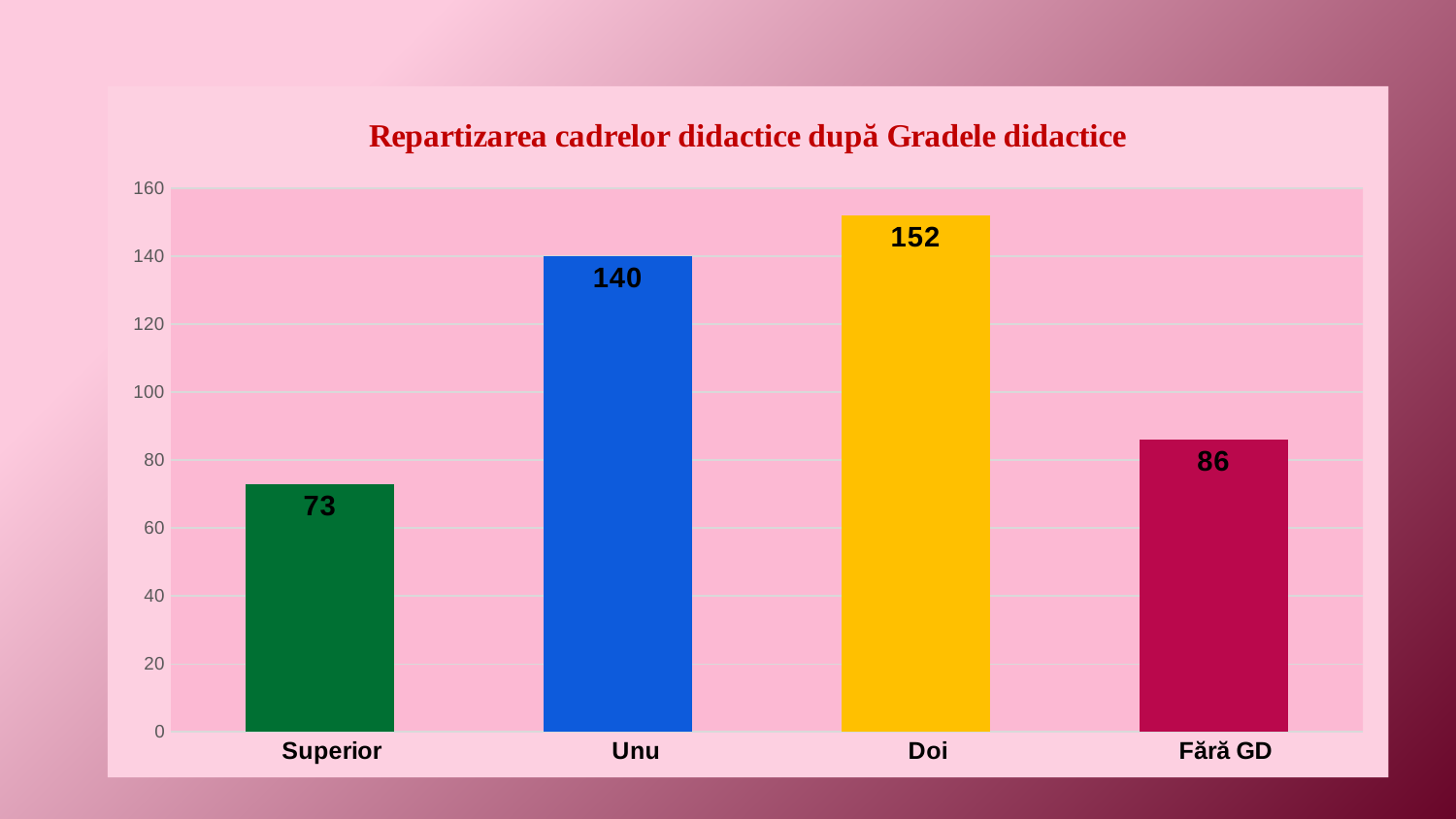
Which category has the highest value? Doi What is the difference between the values for Fără GD and Superior? 13 What is the value for Fără GD? 86 What is the value for Superior? 73 What is the title of the chart? Repartizarea cadrelor didactice după Gradele didactice Which is larger, the value for Unu or the value for Fără GD? Unu What is the value for Unu? 140 How many categories are shown on the x axis? 4 What is the value for Doi? 152 What kind of chart is shown on the slide? Bar chart What is the difference between the values for Doi and Unu? 12 Which category has the lowest value? Superior